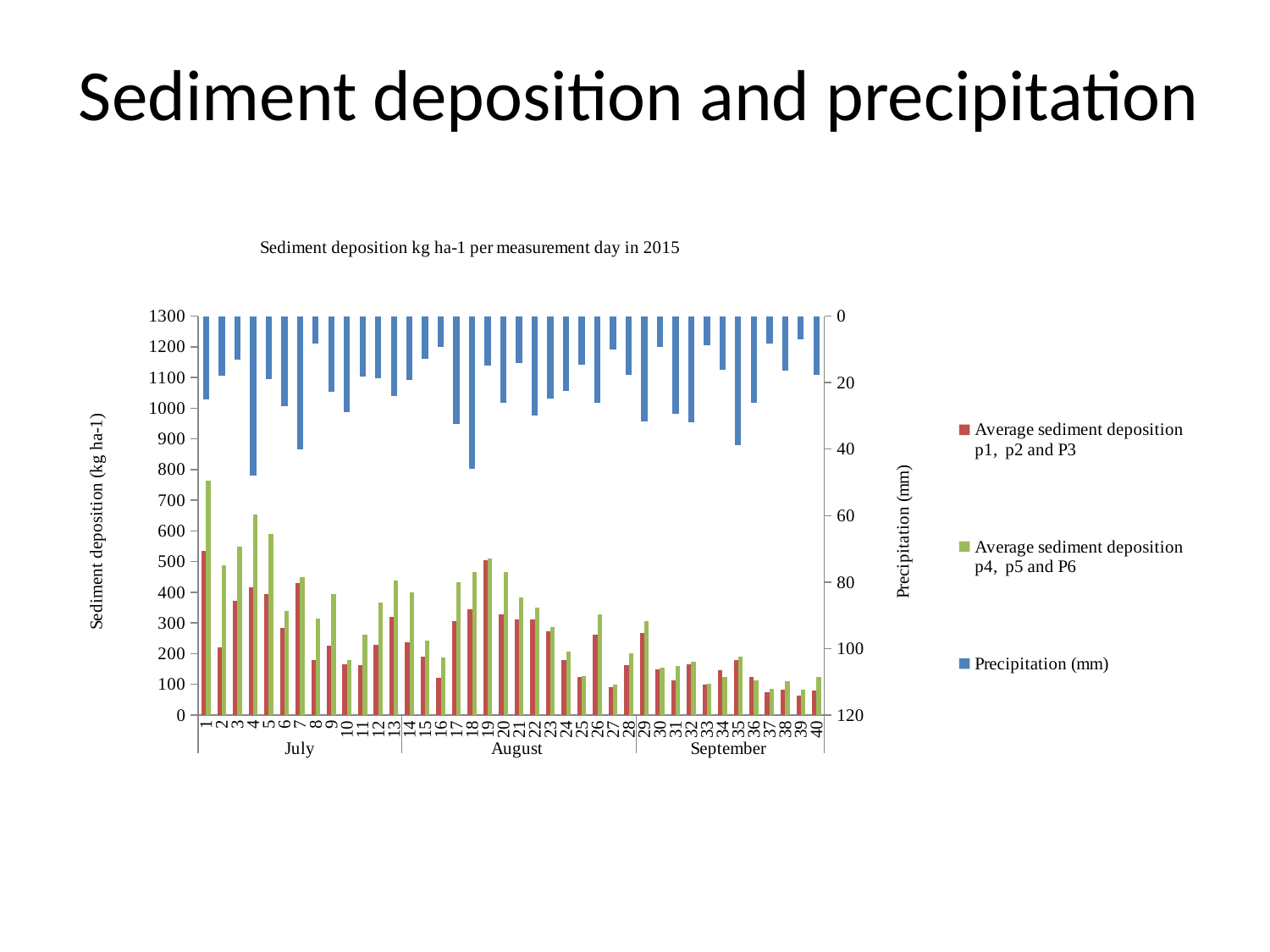
What is the label of the right-hand vertical axis? Precipitation (mm) Is the precipitation on measurement day 18 greater or less than 40 mm? greater Is the average sediment deposition for p4, p5 and P6 on measurement day 4 greater or less than 600? greater Is the average sediment deposition for p1, p2 and P3 on measurement day 1 greater or less than 500? greater How many series does the legend list? 3 On measurement day 26, which is larger: the average sediment deposition for p1, p2 and P3 or for p4, p5 and P6? p4, p5 and P6 How many measurement days are plotted along the x axis? 40 What kind of chart is shown on the slide? bar chart Which measurement day has the highest average sediment deposition for p4, p5 and P6? 1 Does average sediment deposition generally rise or fall from July to September? fall